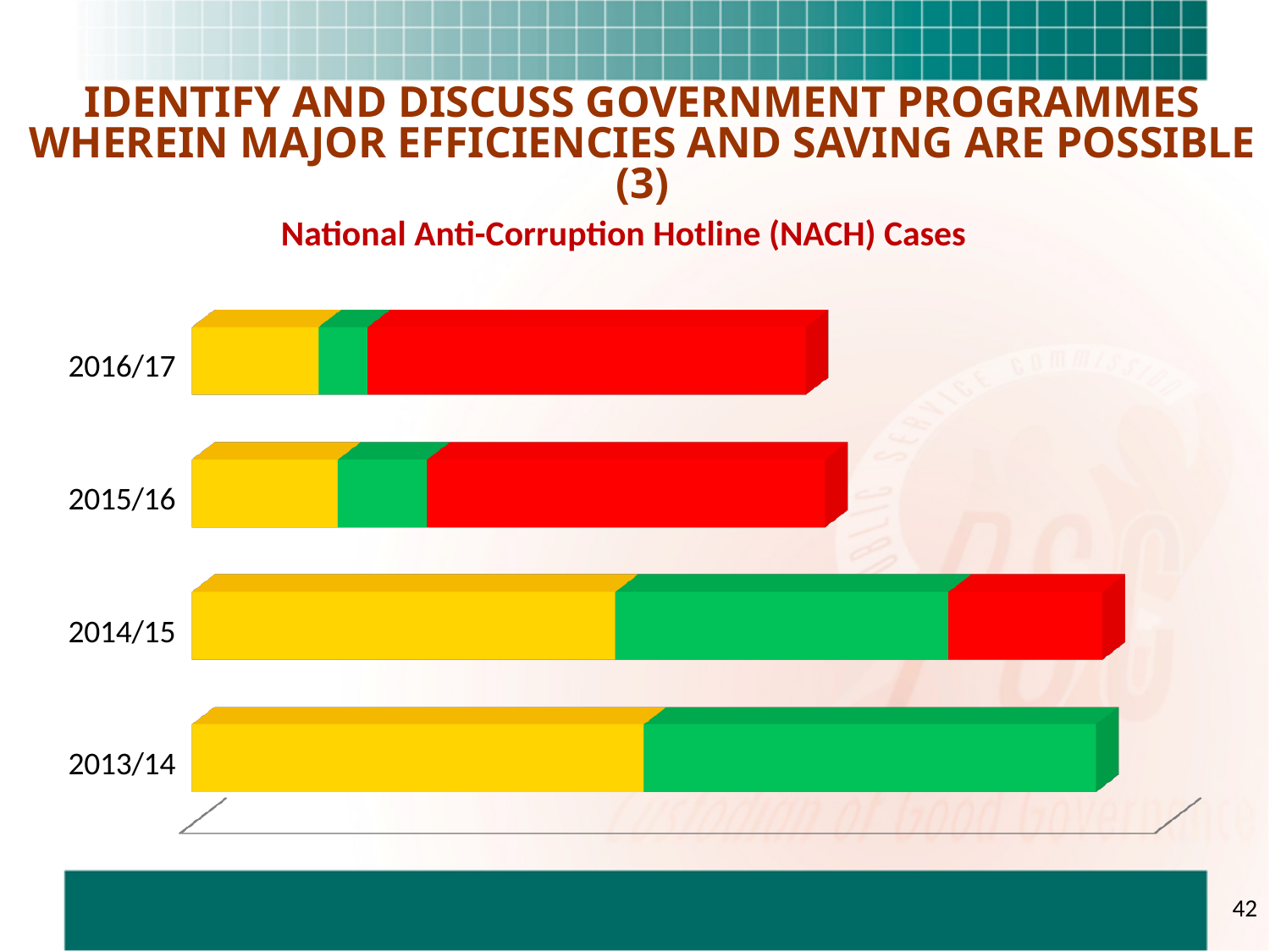
In the 2014/15 bar, which segment is longer, the yellow or the green? Yellow Does the length of the yellow segment increase or decrease from 2013/14 to 2016/17? Decrease In the 2016/17 bar, which segment is longer, the red or the yellow? Red How many coloured segments make up the bar for 2013/14? 2 Which year's bar has no red segment? 2013/14 Which year has the shortest green segment? 2016/17 What kind of chart is shown on the slide? Stacked bar chart In the 2015/16 bar, which segment is longer, the yellow or the green? Yellow What is the title of the chart? National Anti-Corruption Hotline (NACH) Cases Which year has the longest green segment? 2013/14 Which year has the longest red segment? 2016/17 How many financial years are shown on the chart? 4